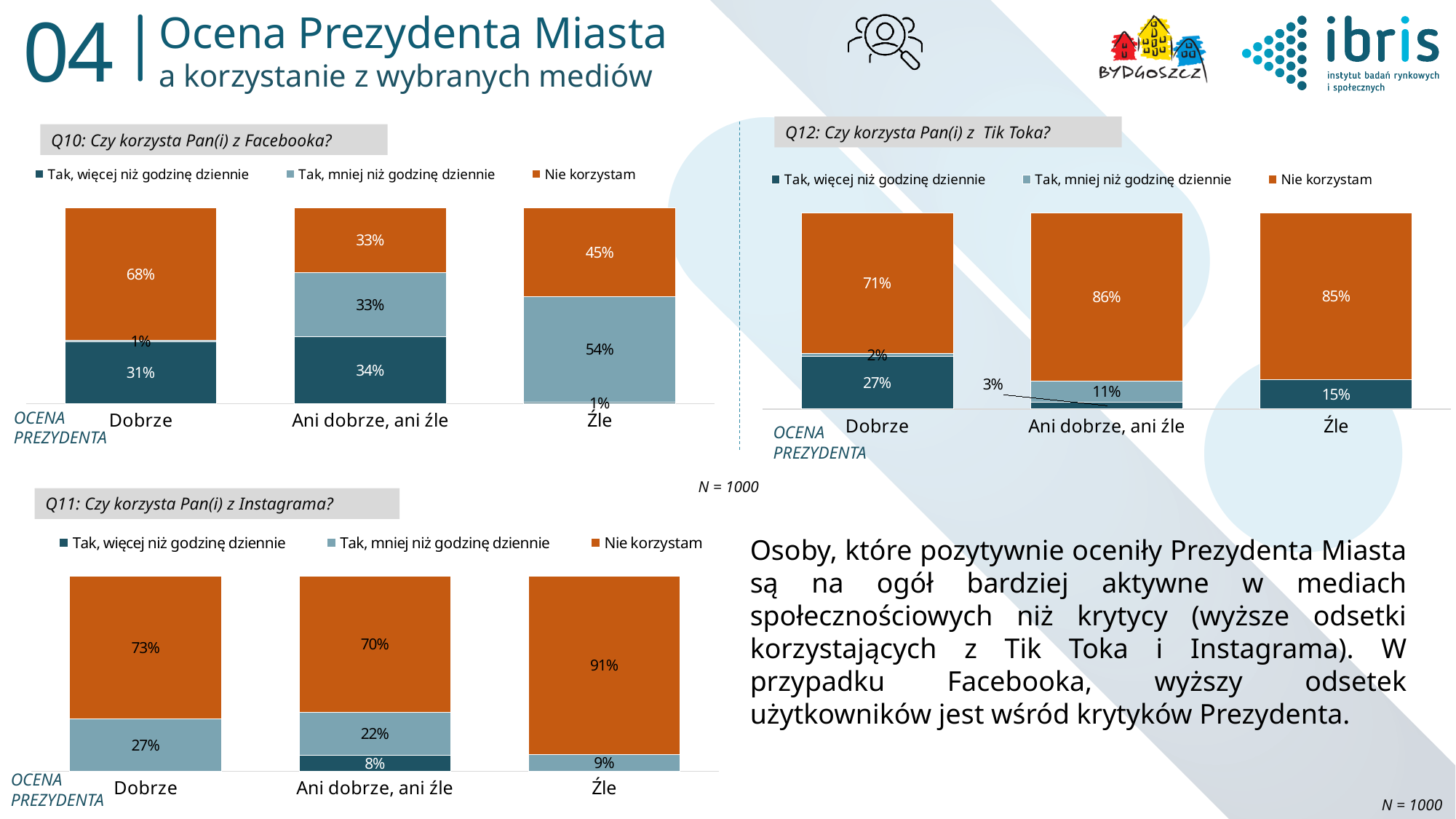
In the Q12 Tik Tok chart, what is the 'Nie korzystam' value for 'Ani dobrze, ani źle'? 86% In the Q11 Instagram chart, which category has the lowest 'Nie korzystam' value? Ani dobrze, ani źle In the Q11 Instagram chart, what is the 'Tak, więcej niż godzinę dziennie' value for 'Ani dobrze, ani źle'? 8% In the Q12 Tik Tok chart, is the 'Tak, więcej niż godzinę dziennie' value larger for 'Dobrze' or for 'Źle'? Dobrze In the Q11 Instagram chart, what is the 'Nie korzystam' value for the 'Źle' category? 91% In the Q10 Facebook chart, what is the value of 'Tak, mniej niż godzinę dziennie' for the 'Źle' category? 54% How many series does the legend of the Q12 Tik Tok chart list? 3 In the Q10 Facebook chart, which category has the highest 'Tak, więcej niż godzinę dziennie' value? Ani dobrze, ani źle What type of chart is used for Q11 Instagram? Stacked bar chart In the Q10 Facebook chart, what is the difference between the 'Nie korzystam' values for 'Dobrze' and 'Źle'? 23% In the Q12 Tik Tok chart, what is the 'Tak, więcej niż godzinę dziennie' value for 'Dobrze'? 27% In the Q10 Facebook chart, what percentage of respondents who rate the President 'Dobrze' answered 'Nie korzystam'? 68%